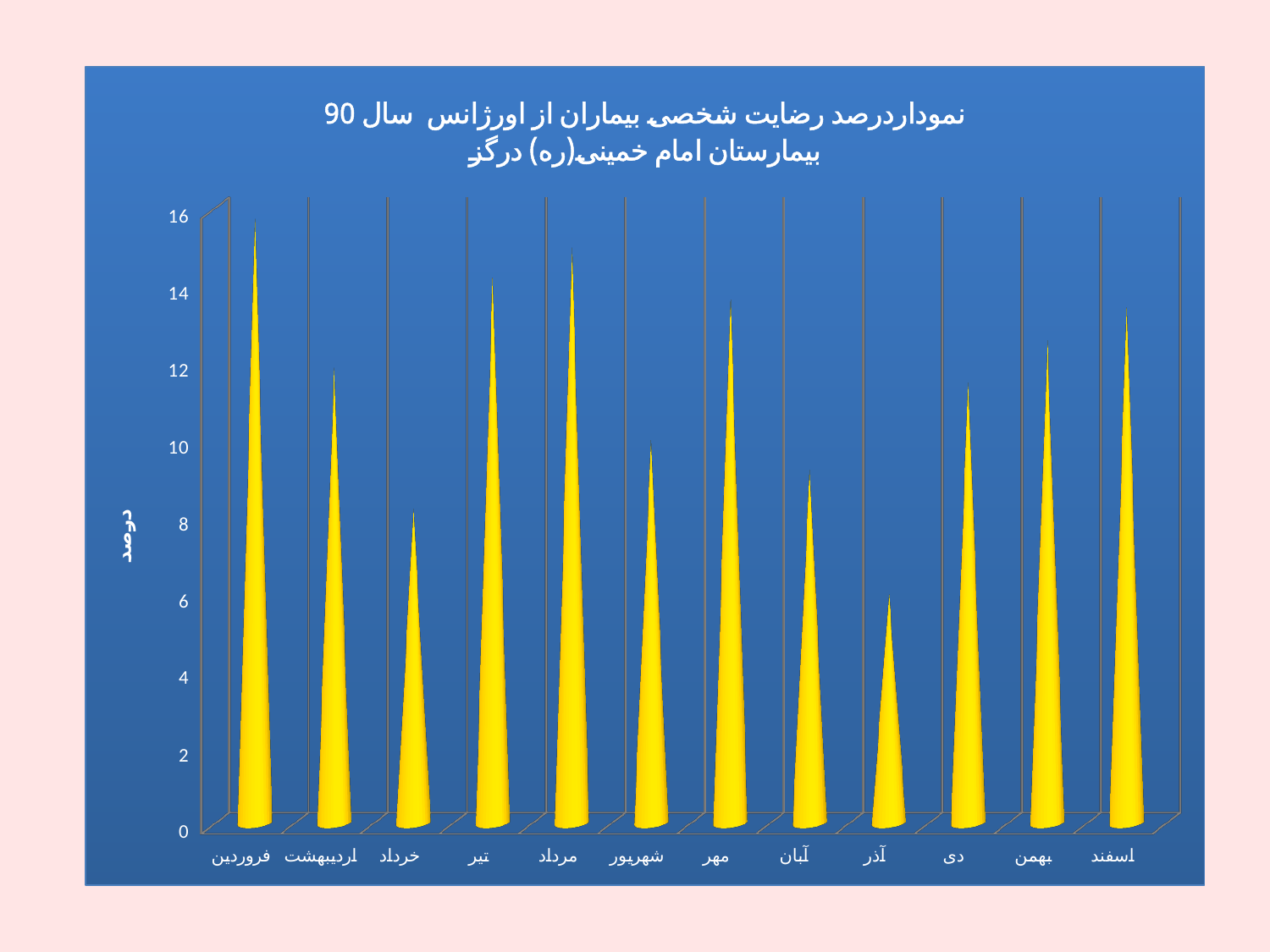
Which month has the highest value? فروردین Which is larger, the value for آذر or the value for دی? دی How many months (categories) are plotted on the x axis? 12 Is the value for خرداد greater or less than 10? less Is the value for آذر greater or less than 8? less What kind of chart is shown on the slide? bar chart Which month has the lowest value? آذر Is the value for مهر greater or less than 12? greater Which is larger, the value for اردیبهشت or the value for خرداد? اردیبهشت What is the label on the vertical axis? درصد